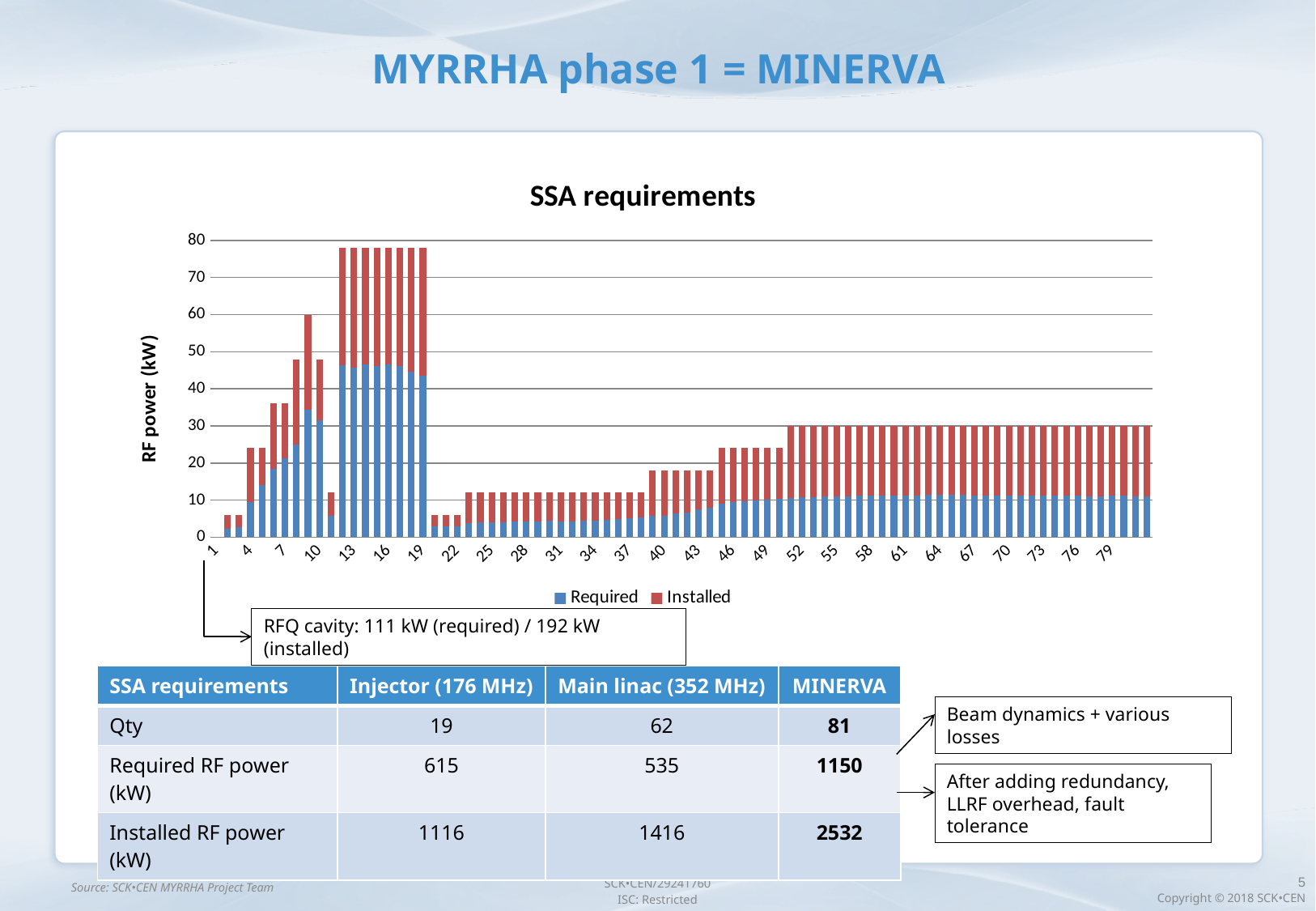
Do the stacked bar totals rise, fall, or stay flat from category 52 to category 79? stay flat How many series does the chart legend list? 2 Is the total stacked value for category 25 greater or less than 20? less Is the total stacked value for category 13 greater or less than 70? greater Is the total stacked value for category 55 greater or less than 20? greater Which has the larger total stacked value, category 13 or category 79? 13 What is the label of the vertical axis of the chart? RF power (kW) What are the two series named in the chart legend? Required and Installed What kind of chart is shown on the slide? Stacked bar chart What is the title of the chart? SSA requirements